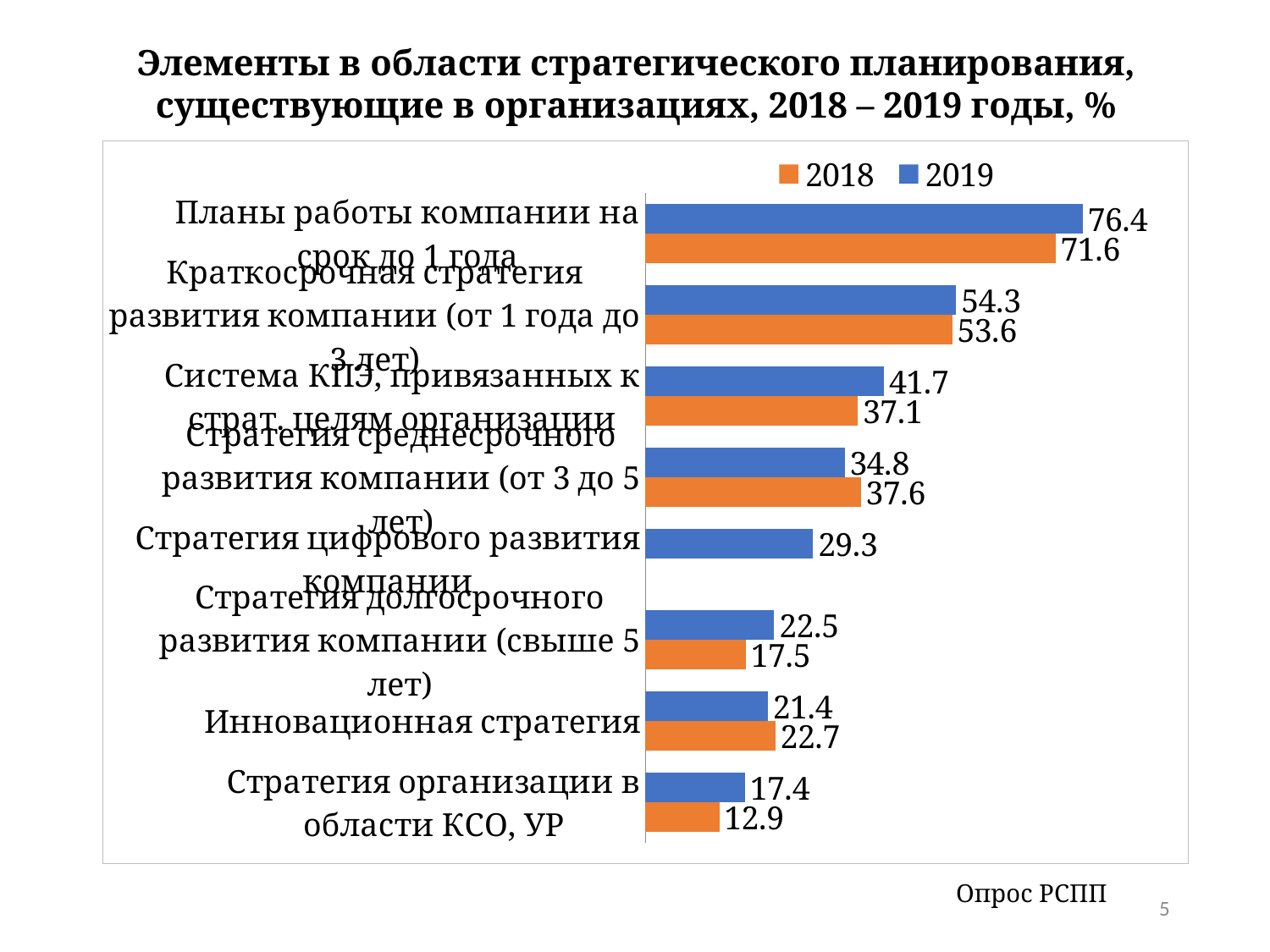
Which colour represents the 2019 series in the chart? blue What is the 2019 value for "Планы работы компании на срок до 1 года"? 76.4 Which category has the highest 2019 value? Планы работы компании на срок до 1 года Which category has the lowest 2018 value? Стратегия организации в области КСО, УР What is the difference between the 2019 and 2018 values for "Стратегия долгосрочного развития компании (свыше 5 лет)"? 5.0 What is the difference between the 2018 and 2019 values for "Стратегия среднесрочного развития компании (от 3 до 5 лет)"? 2.8 What is the 2019 value for "Стратегия цифрового развития компании"? 29.3 For "Инновационная стратегия", which year has the larger value, 2018 or 2019? 2018 What is the 2018 value for "Система КПЭ, привязанных к страт. целям организации"? 37.1 How many categories are shown in the chart? 8 How many series does the legend list? 2 What type of chart is shown on the slide? bar chart